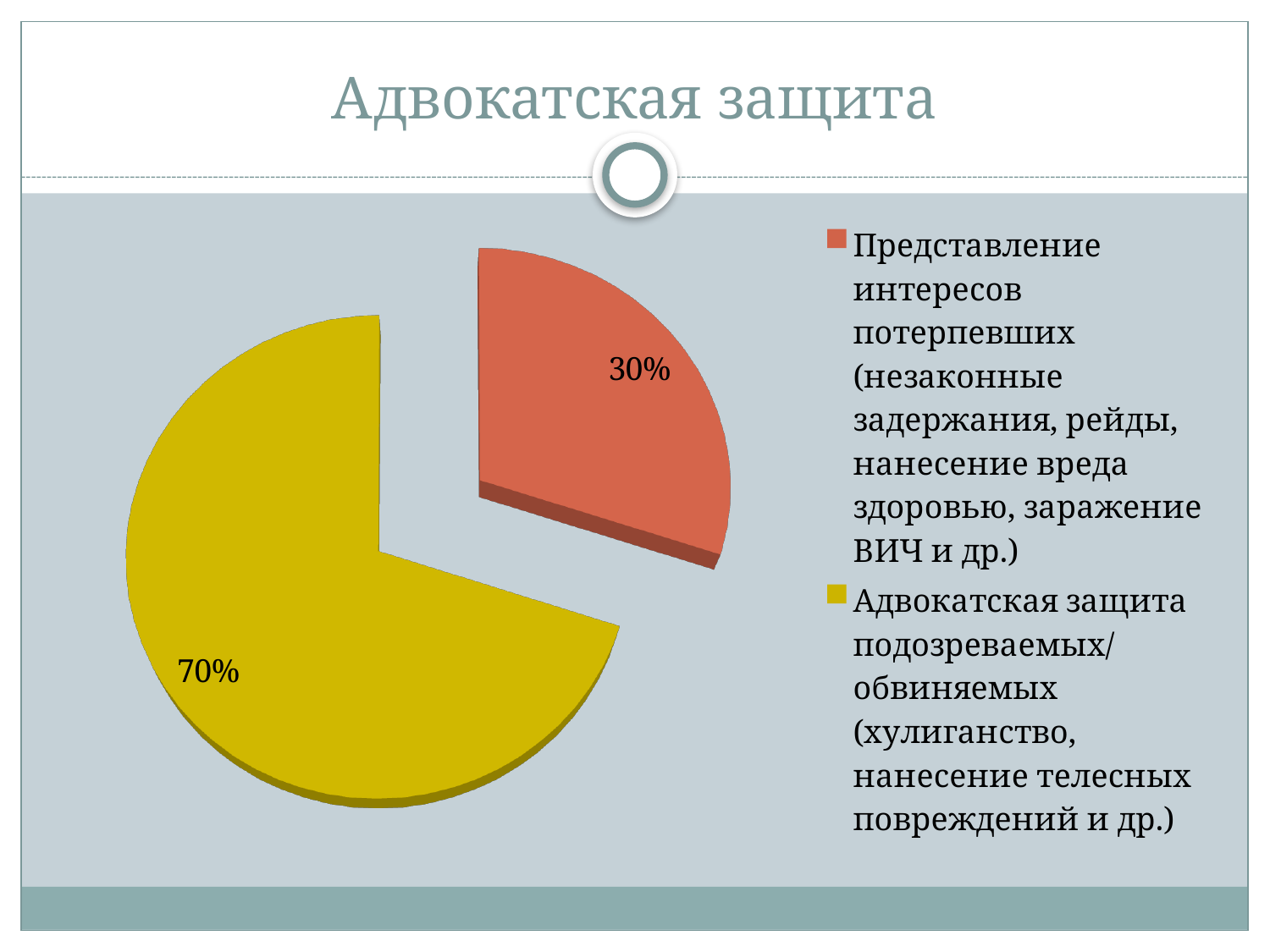
How many slices does the pie chart have? 2 What kind of chart is shown on the slide? pie chart What share of the pie is labelled for 'Адвокатская защита подозреваемых/обвиняемых'? 70% What share of the pie is labelled for 'Представление интересов потерпевших'? 30% Which category has the largest slice of the pie? Адвокатская защита подозреваемых/обвиняемых What is the total of the two percentages shown on the pie chart? 100% Which category has the smallest slice of the pie? Представление интересов потерпевших What is the difference in percentage points between the two slices of the pie? 40 What is the title of the slide containing the pie chart? Адвокатская защита Which is larger: the slice for 'Представление интересов потерпевших' or the slice for 'Адвокатская защита подозреваемых/обвиняемых'? Адвокатская защита подозреваемых/обвиняемых How many entries does the legend list? 2 What colour is the slice for 'Представление интересов потерпевших'? red